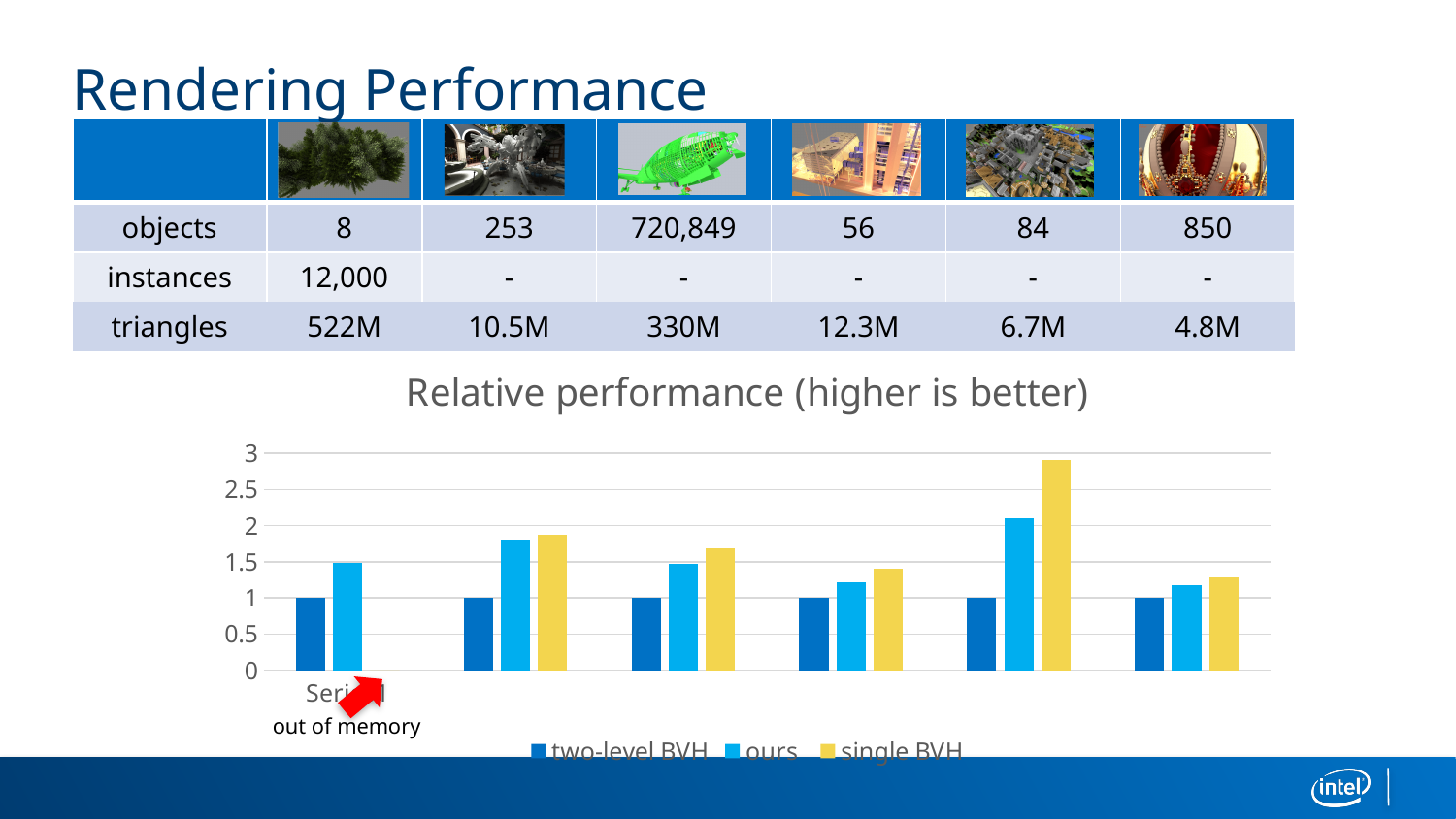
What is the value of the two-level BVH bar in the second group from the left? 1 Is the single BVH value in the fifth group from the left greater or less than 2.5? greater Which series has the tallest bar anywhere in the chart? single BVH In the fifth group from the left, which is larger: the 'ours' bar or the single BVH bar? single BVH Is the single BVH value in the second group from the left greater or less than 1.5? greater What is the title of the chart? Relative performance (higher is better) How many groups of bars are plotted in the chart? 6 Which series is missing from the first group of bars, as explained by the 'out of memory' annotation? single BVH Is the 'ours' value in the fourth group from the left greater or less than 1.5? less What kind of chart is shown on the slide? bar chart How many series does the chart legend list? 3